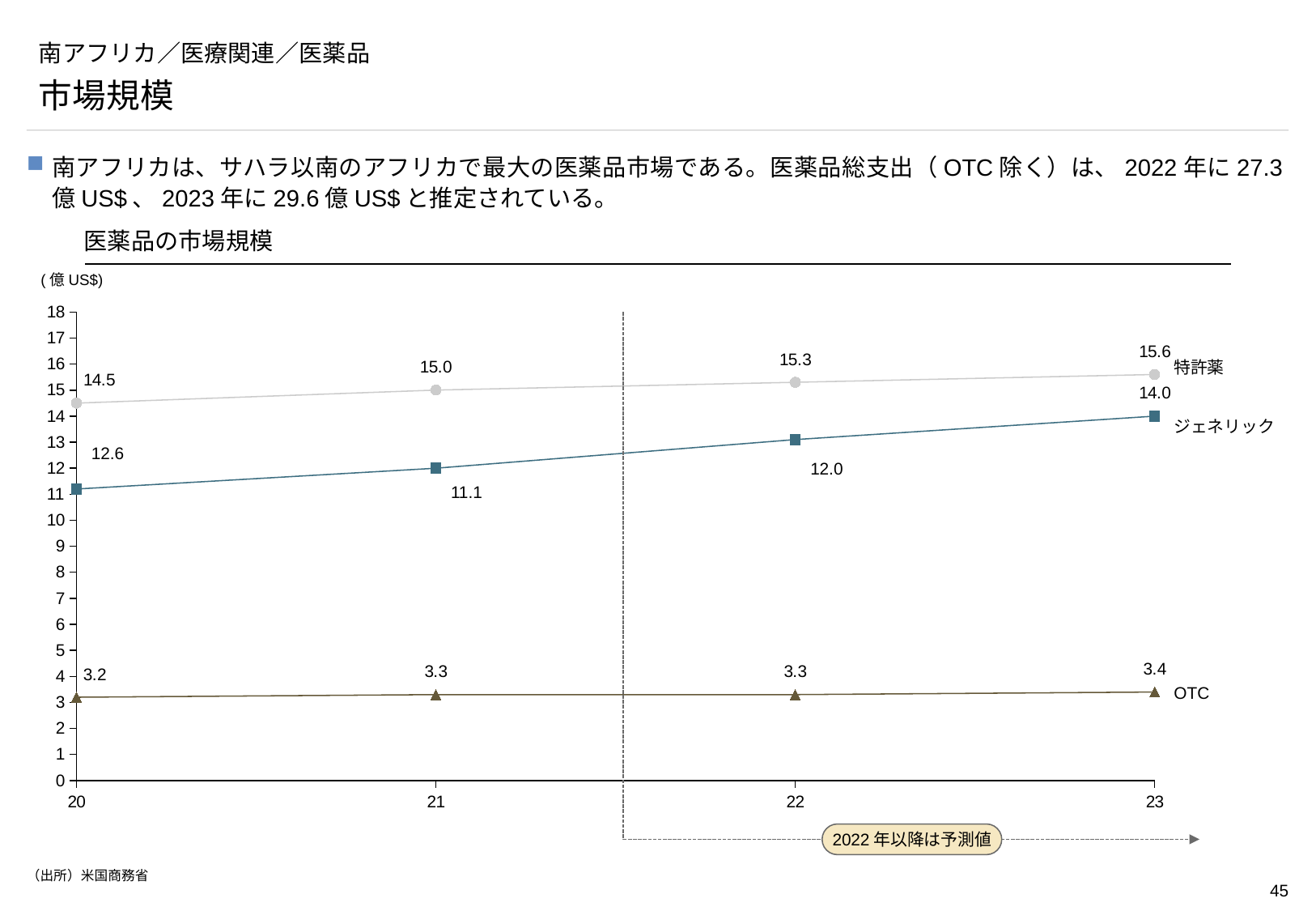
Is the value for ジェネリック in 20 greater or less than 10? greater What is the value for OTC in 21? 3.3 What is the value for 特許薬 in 23? 15.6 Which series has the lowest values across all years? OTC What is the value for OTC in 23? 3.4 In 22, which is larger: 特許薬 or ジェネリック? 特許薬 Which series has the highest value in 23? 特許薬 By how much does the 特許薬 value in 23 exceed its value in 20? 1.1 What is the value for 特許薬 in 20? 14.5 What kind of chart is shown? line chart How many series are plotted in the chart? 3 How many years are plotted on the x axis? 4